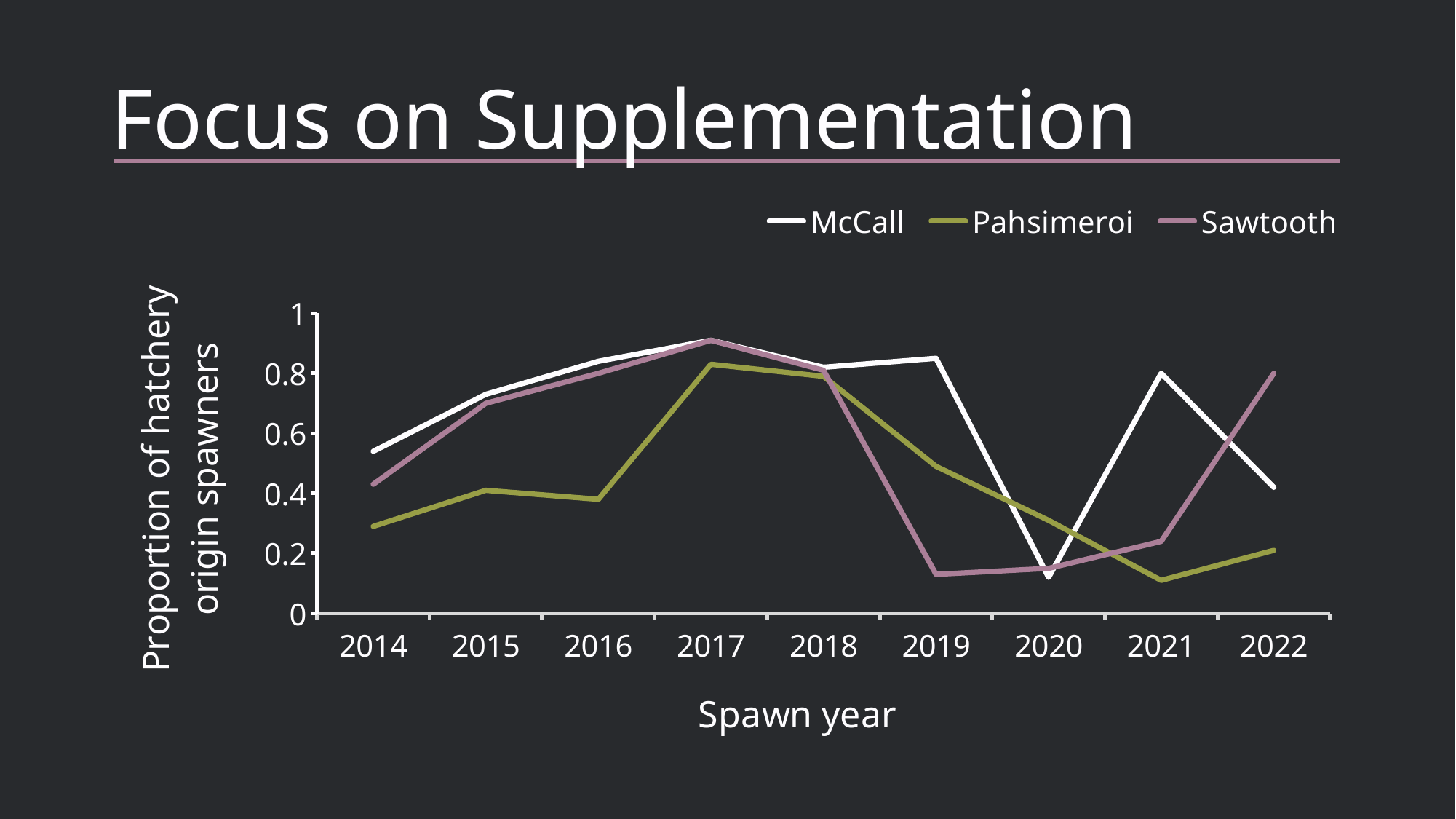
What kind of chart is shown on the slide? line chart Does the McCall line rise or fall from 2014 to 2017? rise Is the value for Pahsimeroi in 2017 greater or less than 0.6? greater Is the value for Sawtooth in 2022 greater or less than 0.6? greater Is the value for McCall in 2020 greater or less than 0.2? less How many series does the legend list? 3 How many spawn years are plotted along the x axis? 9 What is the title of the x axis? Spawn year In 2019, which series has the larger value, McCall or Sawtooth? McCall In which spawn year is the Pahsimeroi value lowest? 2021 In 2014, which series has the larger value, McCall or Pahsimeroi? McCall